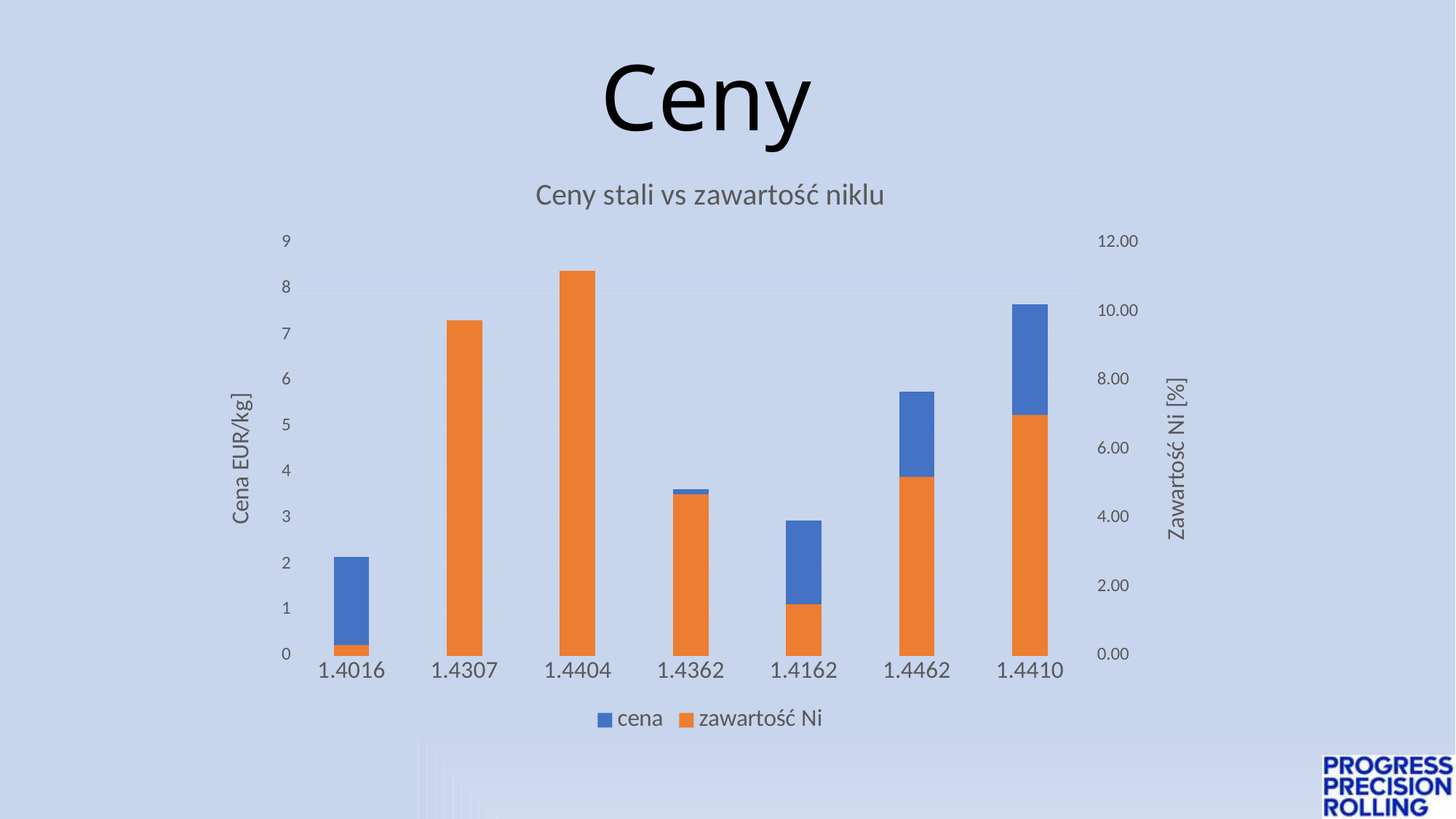
Which has the higher cena, 1.4462 or 1.4410? 1.4410 Which steel grade has the lowest zawartość Ni? 1.4016 How many steel grades (categories) are shown on the x axis of the chart? 7 Which has the higher zawartość Ni, 1.4307 or 1.4404? 1.4404 What kind of chart is shown on the slide? bar chart What is the label of the right-hand vertical axis? Zawartość Ni [%] Is the cena value for 1.4410 greater or less than 7? greater Is the zawartość Ni value for 1.4016 greater or less than 2.00? less Which steel grade has the highest zawartość Ni? 1.4404 Is the zawartość Ni value for 1.4404 greater or less than 10.00? greater How many series does the chart legend list? 2 What is the title of the chart? Ceny stali vs zawartość niklu